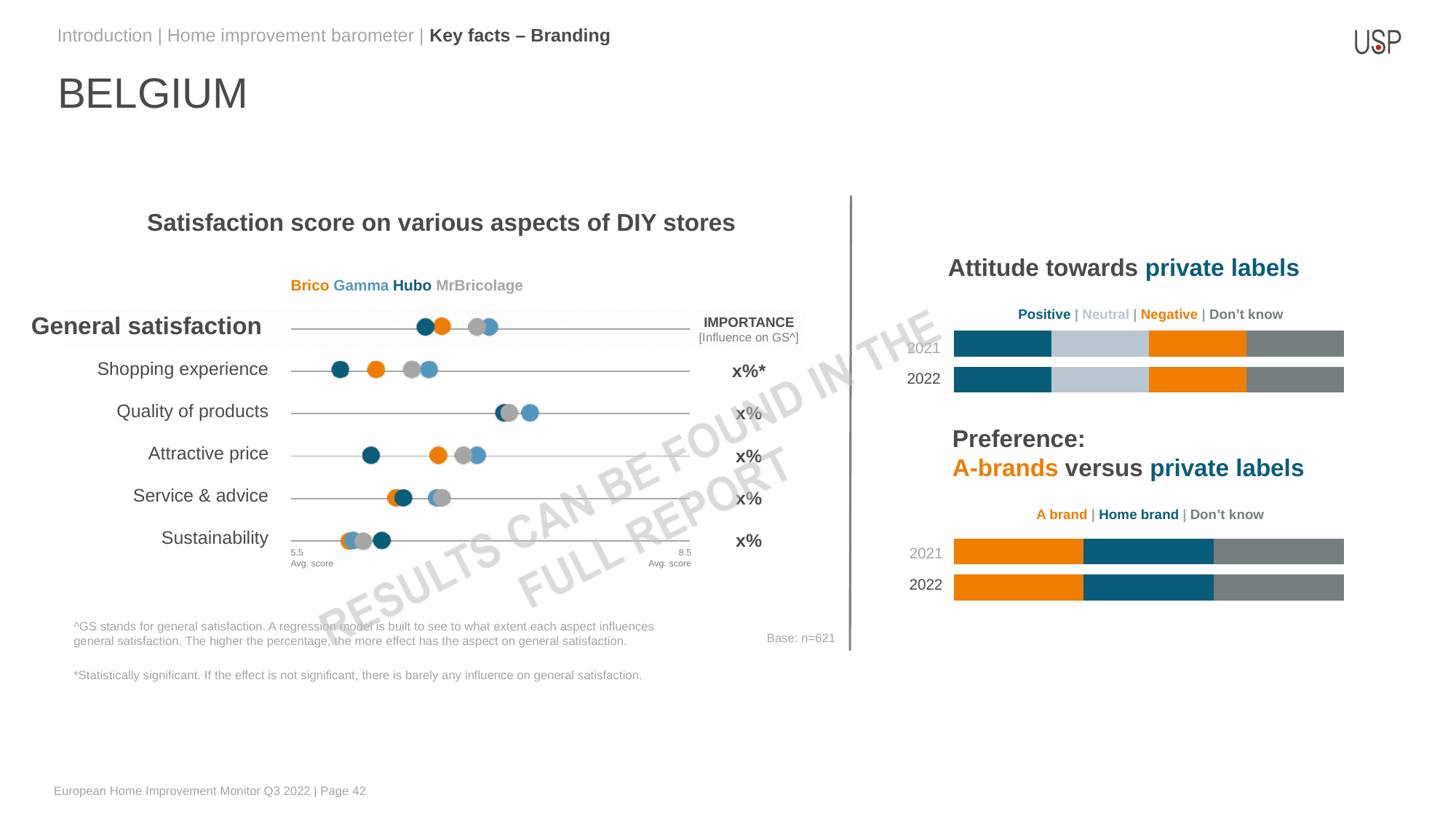
How many categories does the legend of the 'Preference: A-brands versus private labels' chart list? 3 In the 'Satisfaction score on various aspects of DIY stores' chart, which store has the highest score for Quality of products? Gamma In the 'Satisfaction score on various aspects of DIY stores' chart, which store scores higher on Sustainability, Brico or Hubo? Hubo How many aspects are listed in the 'Satisfaction score on various aspects of DIY stores' chart? 6 In the 'Satisfaction score on various aspects of DIY stores' chart, which store has the lowest score for Shopping experience? Hubo How many stores does the legend of the 'Satisfaction score on various aspects of DIY stores' chart list? 4 Which years are shown in the 'Preference: A-brands versus private labels' chart? 2021 and 2022 What kind of chart is 'Satisfaction score on various aspects of DIY stores'? Dot plot What kind of chart is 'Attitude towards private labels'? Stacked bar chart In the 'Satisfaction score on various aspects of DIY stores' chart, which store has the lowest score for Attractive price? Hubo How many categories does the legend of the 'Attitude towards private labels' chart list? 4 In the 'Satisfaction score on various aspects of DIY stores' chart, what are the minimum and maximum values shown on the average score axis? 5.5 and 8.5